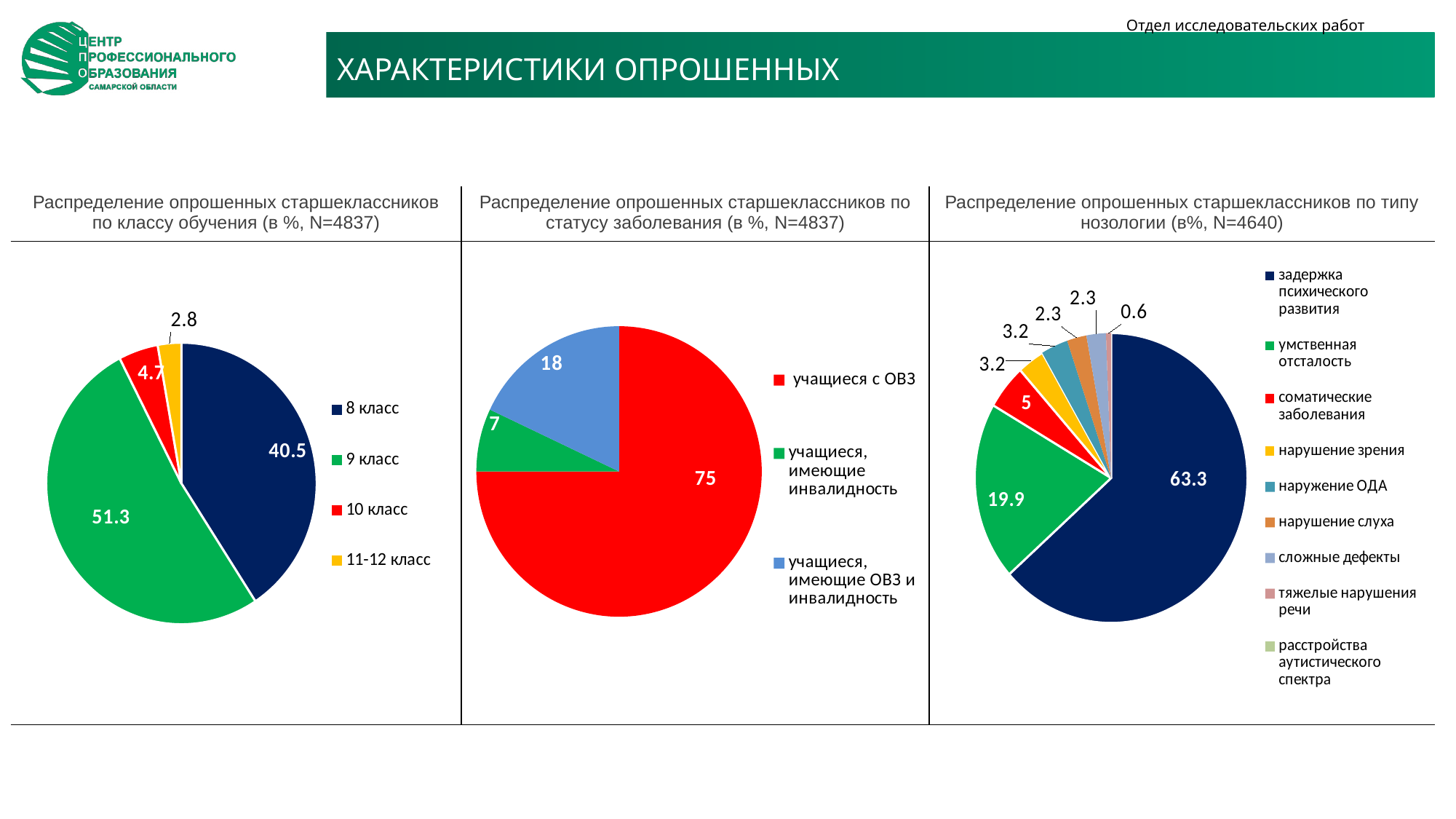
In the right chart (по типу нозологии), what is the share for умственная отсталость? 19.9 What type of chart is the middle chart (по статусу заболевания)? pie chart In the middle chart (по статусу заболевания), which is larger: учащиеся, имеющие инвалидность or учащиеся, имеющие ОВЗ и инвалидность? учащиеся, имеющие ОВЗ и инвалидность In the right chart (по типу нозологии), how many categories does the legend list? 9 In the right chart (по типу нозологии), which category has the largest share? задержка психического развития What is the sample size (N) stated in the title of the right chart (по типу нозологии)? N=4640 In the left chart (по классу обучения), what percentage of respondents are in 9 класс? 51.3 In the middle chart (по статусу заболевания), what share of respondents are учащиеся с ОВЗ? 75 In the left chart (по классу обучения), what is the difference between the shares of 9 класс and 8 класс? 10.8 In the right chart (по типу нозологии), what is the share for задержка психического развития? 63.3 In the left chart (по классу обучения), which class has the smallest share of respondents? 11-12 класс In the left chart (по классу обучения), how many categories does the legend list? 4